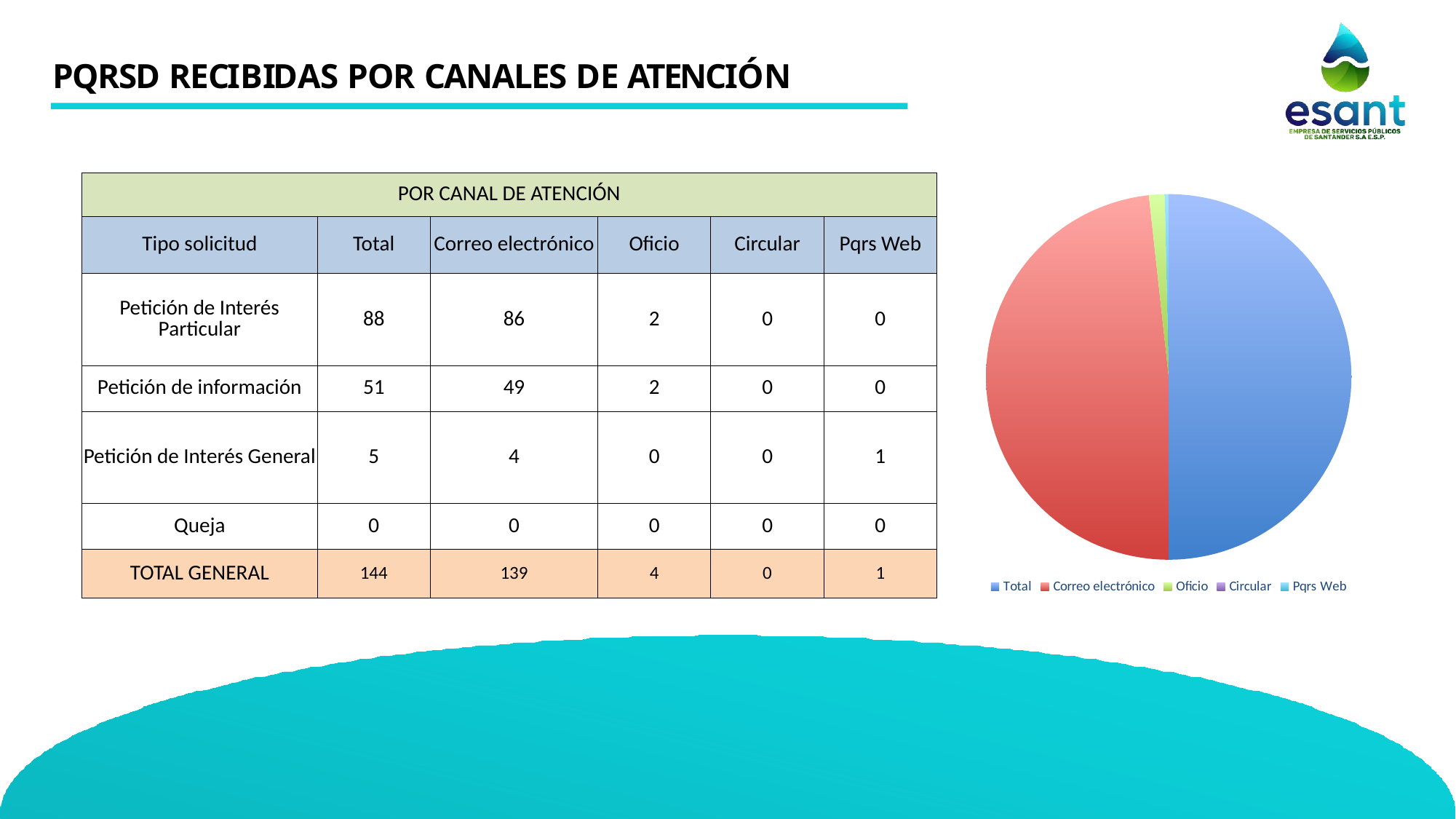
How many entries does the pie chart's legend list? 5 Does the Oficio slice of the pie chart take up more or less than a quarter of the pie? less What colour is the Correo electrónico slice in the pie chart? red Which entry is listed first in the pie chart's legend? Total In the pie chart, which slice is larger: Oficio or Correo electrónico? Correo electrónico In the pie chart, which slice is larger: Total or Oficio? Total In the pie chart, which slice is larger: Correo electrónico or Pqrs Web? Correo electrónico What kind of chart is shown on the slide? pie chart Does the Total slice of the pie chart take up more or less than a quarter of the pie? more